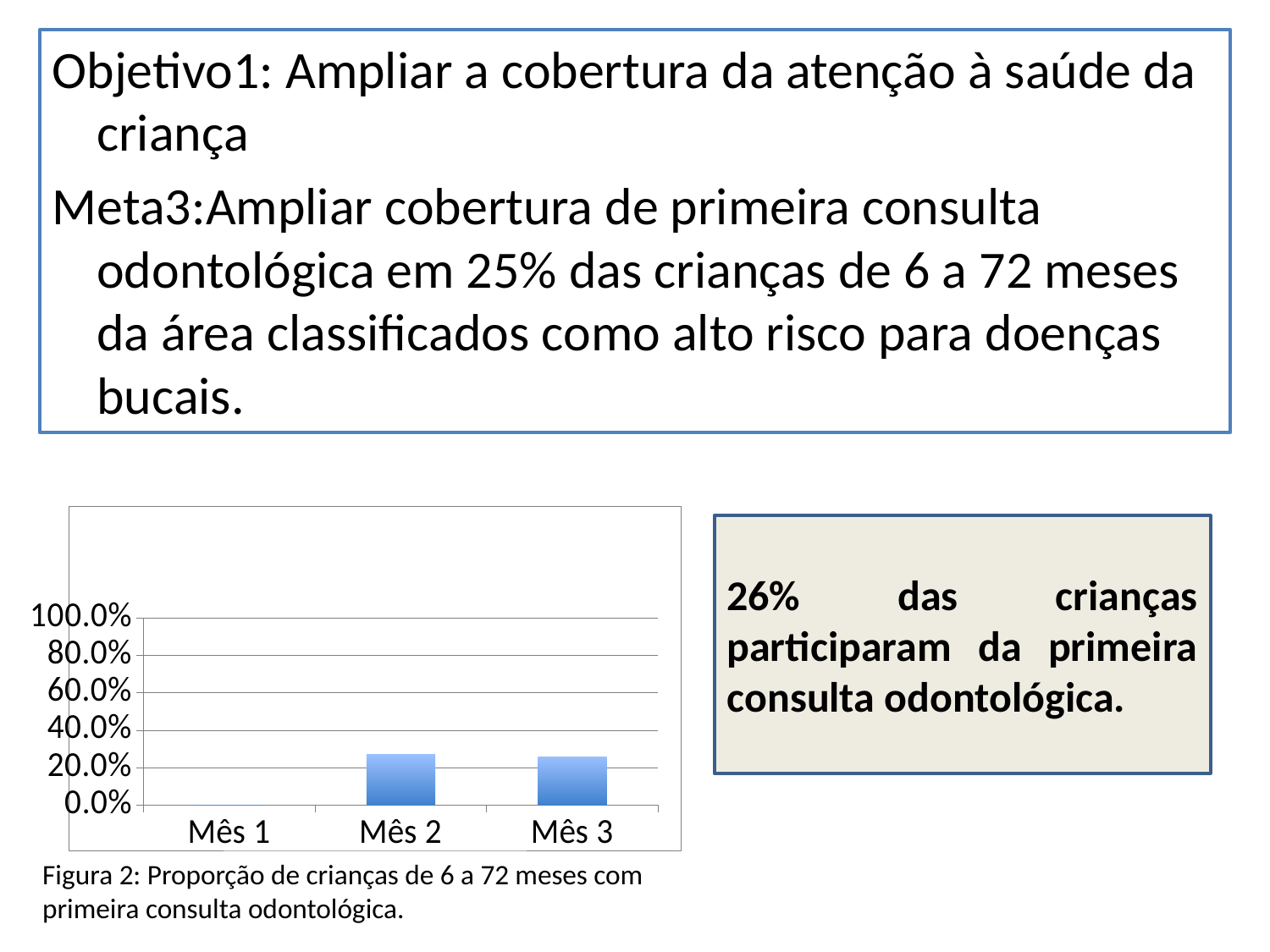
Is the value for Mês 2 greater or less than 40.0%? less Is the value for Mês 2 greater or less than 20.0%? greater What kind of chart is shown in Figura 2? bar chart How many months (categories) are shown on the x axis of the chart? 3 Is the value for Mês 3 greater or less than 60.0%? less Which is larger, the value for Mês 1 or the value for Mês 3? Mês 3 What is the highest tick value shown on the y axis of the chart? 100.0% Which is larger, the value for Mês 1 or the value for Mês 2? Mês 2 What is the figure number given in the caption below the chart? Figura 2 Which month has the lowest value in the chart? Mês 1